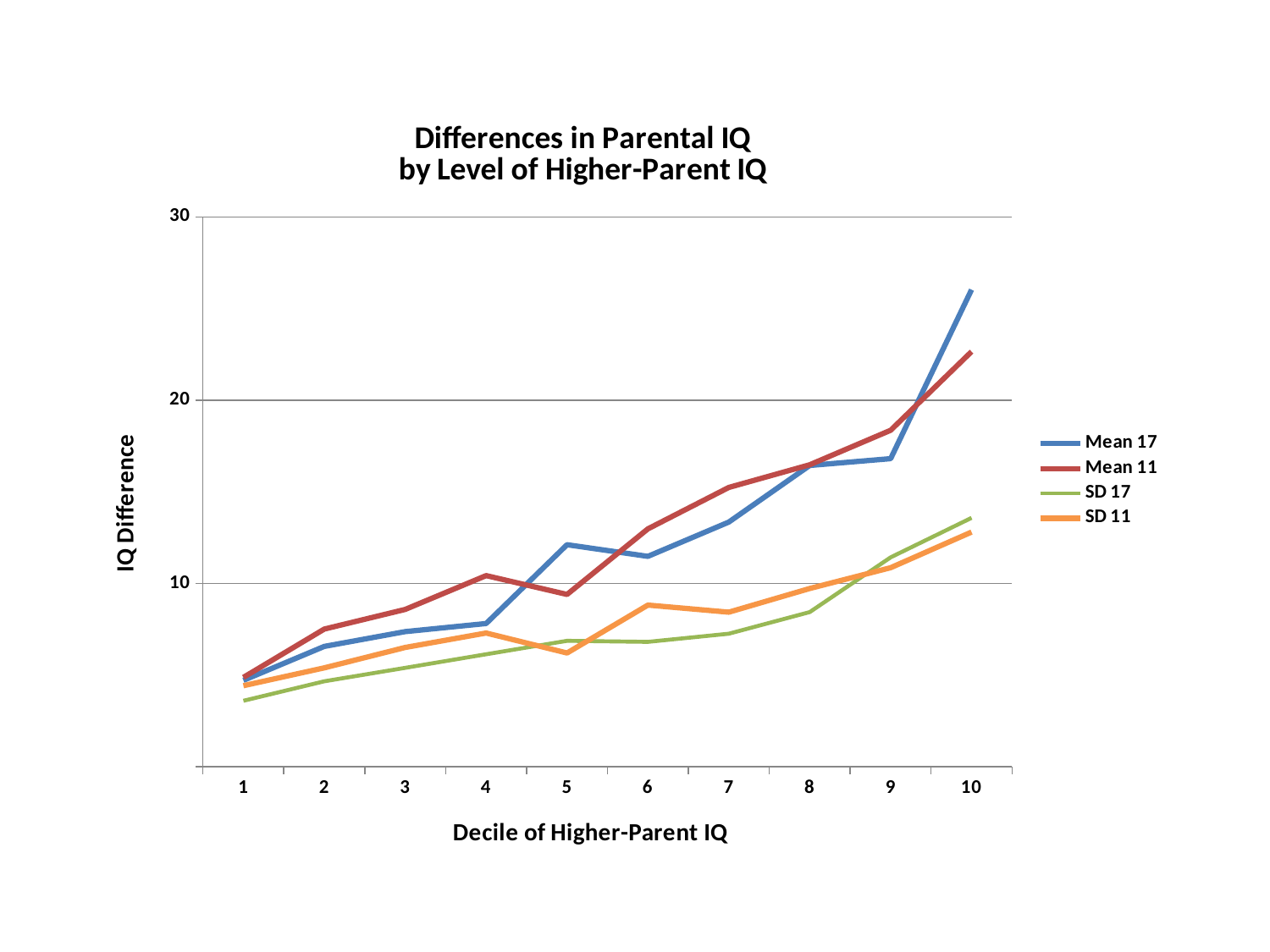
Is the value for Mean 17 at decile 10 greater or less than 20? greater Is the value for SD 17 at decile 1 greater or less than 10? less What kind of chart is shown on the slide? line chart What is the title of the chart? Differences in Parental IQ by Level of Higher-Parent IQ How many series does the legend list? 4 Is the value for Mean 17 at decile 5 greater or less than 10? greater Which series has the lowest value at decile 6? SD 17 Which series has the highest value at decile 10? Mean 17 How many deciles are plotted along the x axis? 10 At decile 5, which is larger: Mean 17 or Mean 11? Mean 17 What is the label of the y axis? IQ Difference